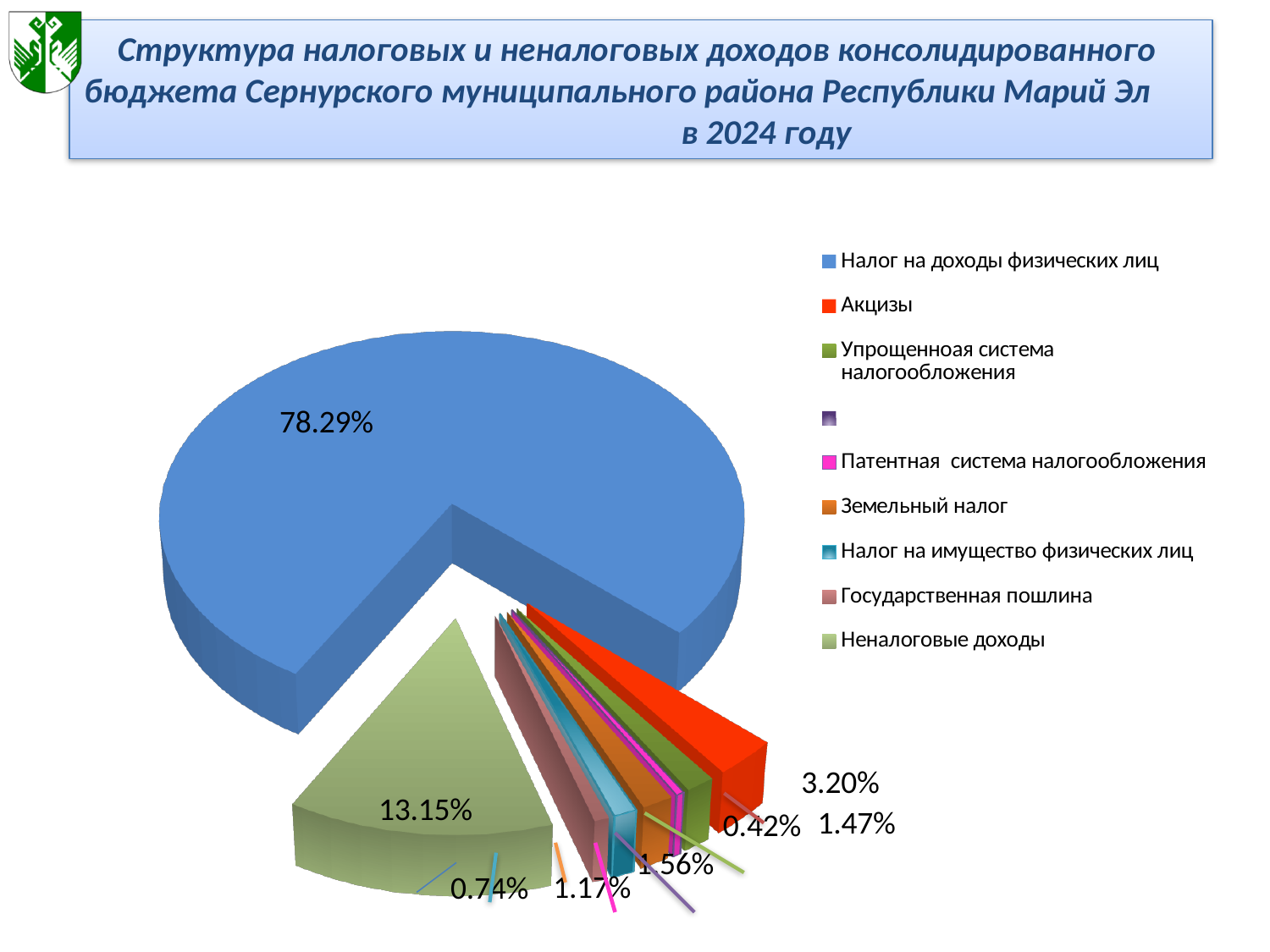
What share of the pie does Патентная система налогообложения have? 0.42% How many entries does the legend list? 9 Which is larger, the slice for Неналоговые доходы or the slice for Акцизы? Неналоговые доходы Which category has the largest slice of the pie? Налог на доходы физических лиц What kind of chart is shown on the slide? pie chart What share of the pie does Неналоговые доходы have? 13.15% What share of the pie does Налог на доходы физических лиц have? 78.29% What share of the pie does Земельный налог have? 1.56% What share of the pie does Упрощенная система налогообложения have? 1.47% What share of the pie does Налог на имущество физических лиц have? 1.17% What share of the pie does Акцизы have? 3.20% What is the difference in percentage points between the slices for Налог на доходы физических лиц and Неналоговые доходы? 65.14